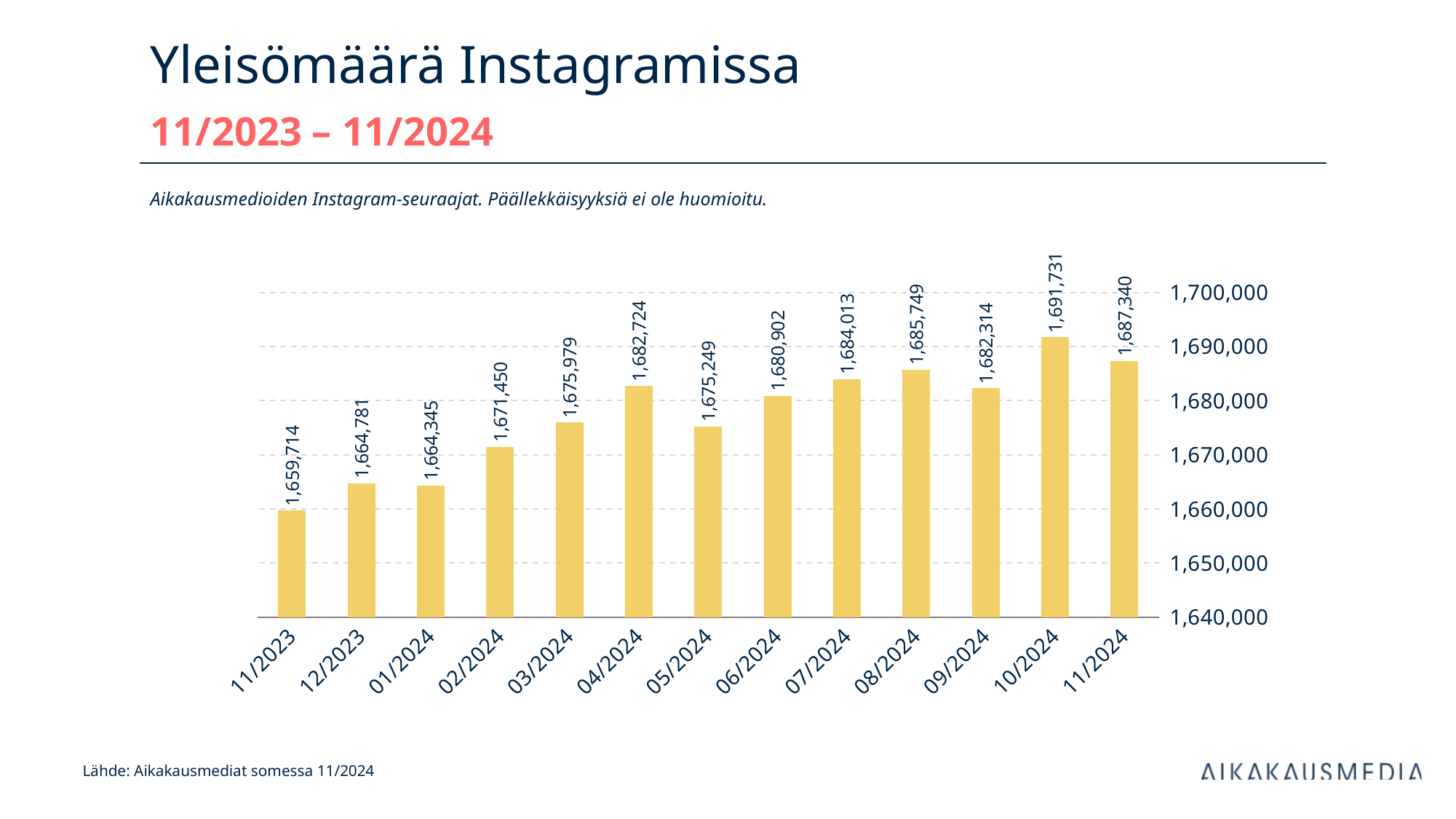
What is the value for 04/2024? 1,682,724 Which month has the lowest value? 11/2023 What is the value for 11/2023? 1,659,714 What is the value for 11/2024? 1,687,340 Is the value for 02/2024 greater or less than 1,680,000? less What is the difference between the values for 10/2024 and 11/2024? 4,391 What kind of chart is shown on the slide? bar chart Which month has the highest value? 10/2024 What is the difference between the values for 11/2024 and 11/2023? 27,626 How many months are shown on the x axis? 13 Which is larger, the value for 05/2024 or the value for 06/2024? 06/2024 Do the values generally rise or fall from 11/2023 to 11/2024? rise